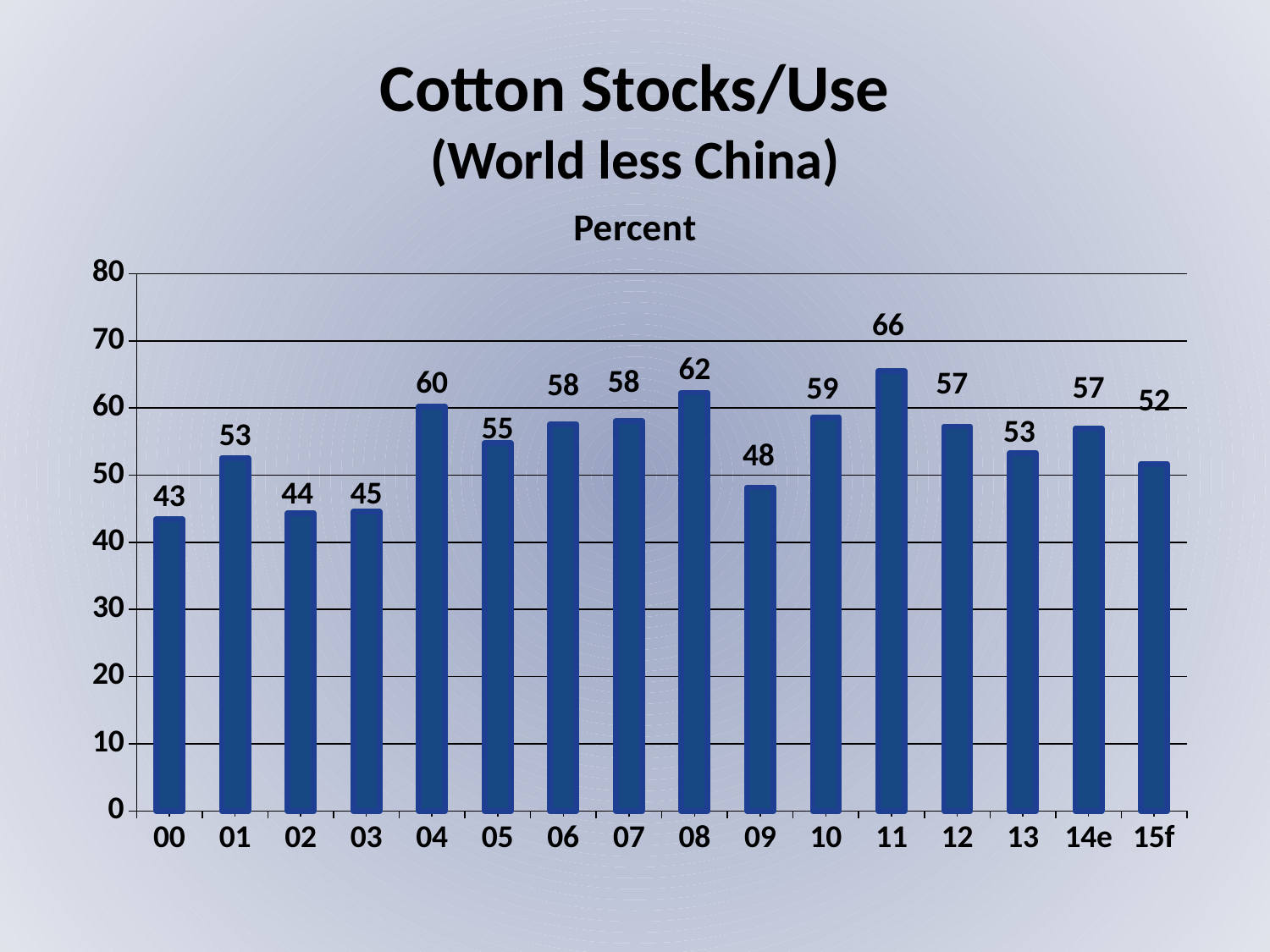
How many bars are shown in the chart? 16 Which year has the highest value? 11 What is the value for 11? 66 What is the title of the chart? Percent Which year has the lowest value? 00 What is the value for 00? 43 Which is larger, the value for 08 or the value for 10? 08 What is the difference between the values for 11 and 09? 18 What is the value for 15f? 52 What kind of chart is shown? bar chart Do the values rise or fall from 00 to 04? rise Is the value for 04 greater or less than 50? greater